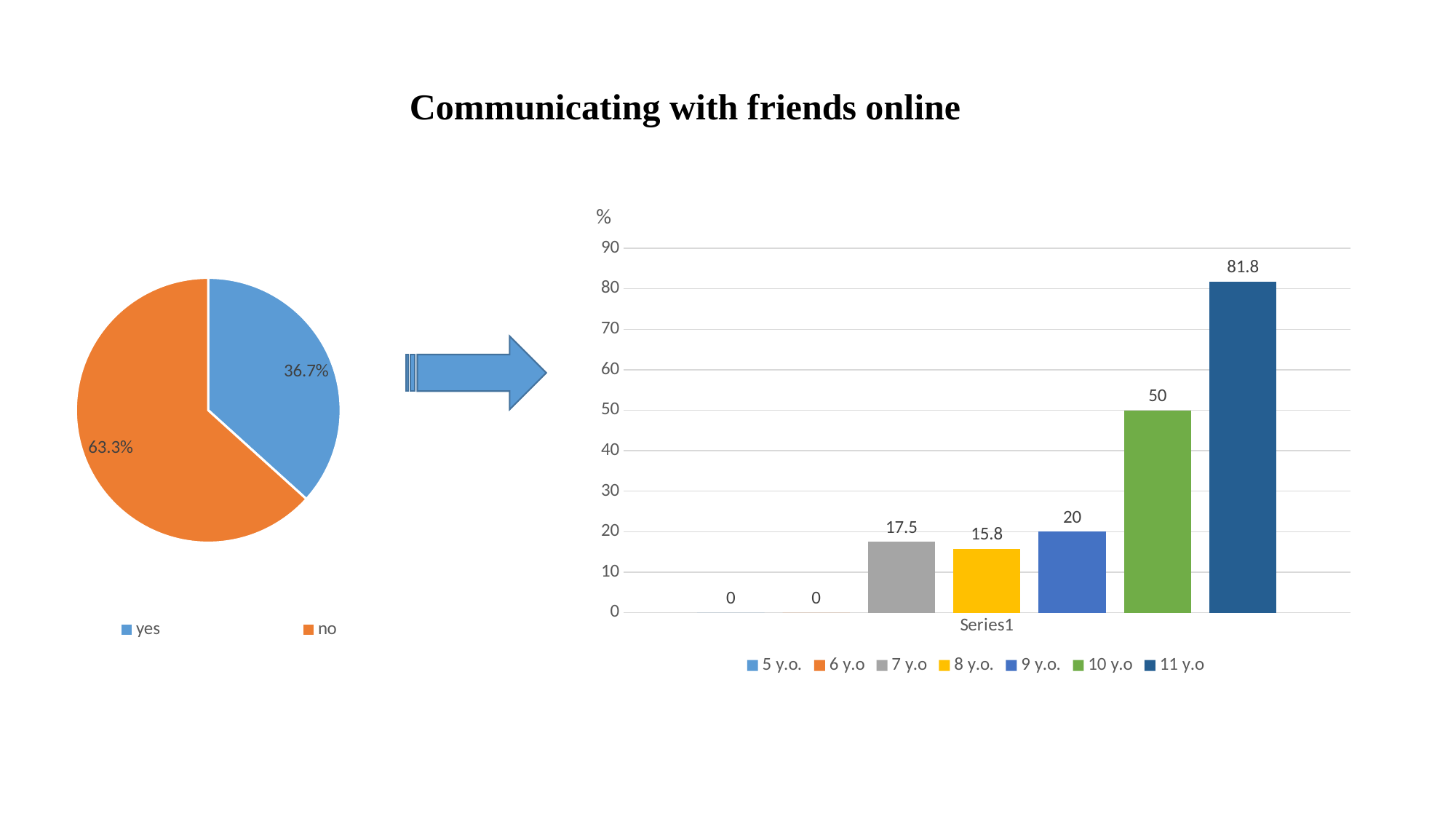
In the pie chart on the left, which slice is larger, "yes" or "no"? no What kind of chart is the chart on the left? pie chart In the bar chart on the right, what is the difference between the values for 11 y.o and 10 y.o? 31.8 In the bar chart on the right, which is larger, the value for 7 y.o or the value for 9 y.o.? 9 y.o. How many entries does the legend of the bar chart on the right list? 7 In the bar chart on the right, which age group has the highest value? 11 y.o What kind of chart is the chart on the right? bar chart In the pie chart on the left, what share is labelled for "yes"? 36.7% In the pie chart on the left, what share is labelled for "no"? 63.3% In the bar chart on the right, what is the value for 8 y.o.? 15.8 In the bar chart on the right, do the values rise or fall as age increases from 7 y.o to 11 y.o? rise In the bar chart on the right, what is the value for 11 y.o? 81.8